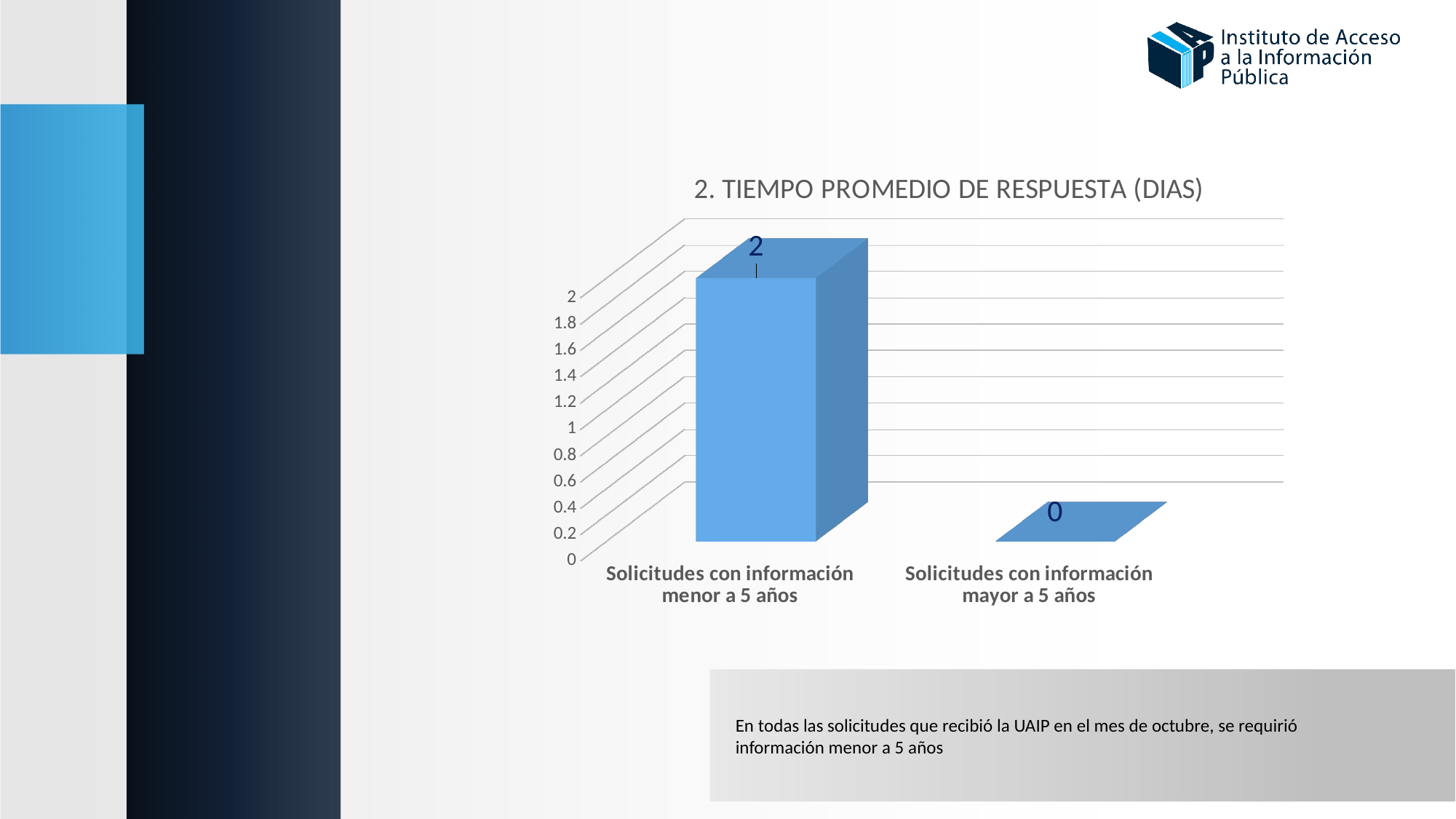
How many categories are shown on the chart? 2 What is the value for "Solicitudes con información menor a 5 años"? 2 Which category has the highest value? Solicitudes con información menor a 5 años What kind of chart is shown on the slide? bar chart What is the difference between the values for "Solicitudes con información menor a 5 años" and "Solicitudes con información mayor a 5 años"? 2 What is the value for "Solicitudes con información mayor a 5 años"? 0 Which is larger: the value for "Solicitudes con información menor a 5 años" or for "Solicitudes con información mayor a 5 años"? Solicitudes con información menor a 5 años What is the title of the chart? 2. TIEMPO PROMEDIO DE RESPUESTA (DIAS) Is the value for "Solicitudes con información menor a 5 años" greater or less than 1? greater What is the maximum value shown on the vertical axis of the chart? 2 Which category has the lowest value? Solicitudes con información mayor a 5 años